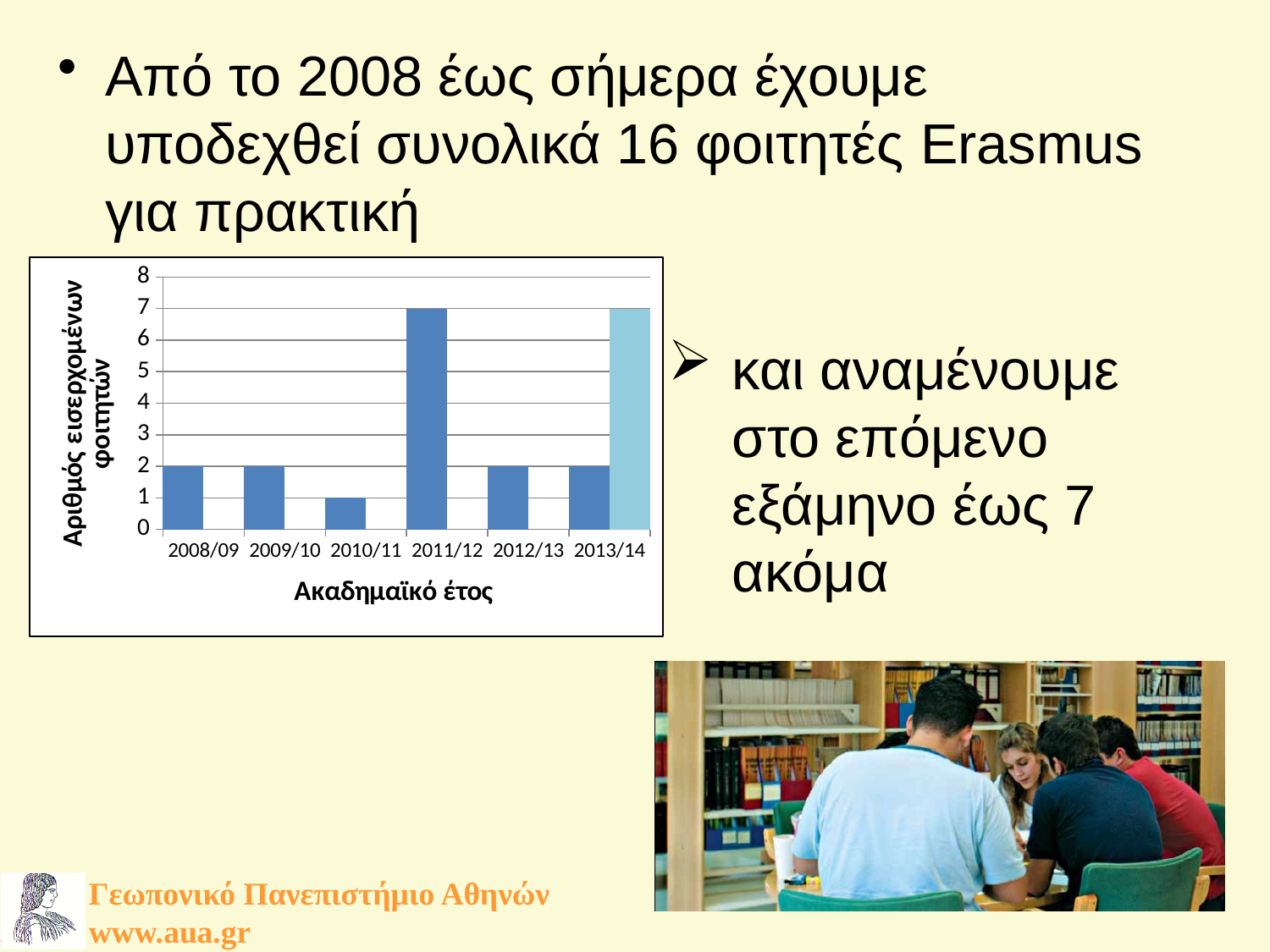
What kind of chart is shown on the slide? bar chart Is the value for 2011/12 greater or less than 5? greater What is the difference between the values for 2011/12 and 2010/11 in the chart? 6 How many academic years are shown on the x axis of the chart? 6 Which bar in the chart is drawn in a lighter blue than the others? 2013/14 What is the value for 2010/11 in the chart? 1 Which academic year has the lowest value in the chart? 2010/11 What is the value for 2008/09 in the chart? 2 What is the value for 2011/12 in the chart? 7 Which is larger in the chart, the value for 2011/12 or the value for 2012/13? 2011/12 What is the x-axis title of the chart? Ακαδημαϊκό έτος